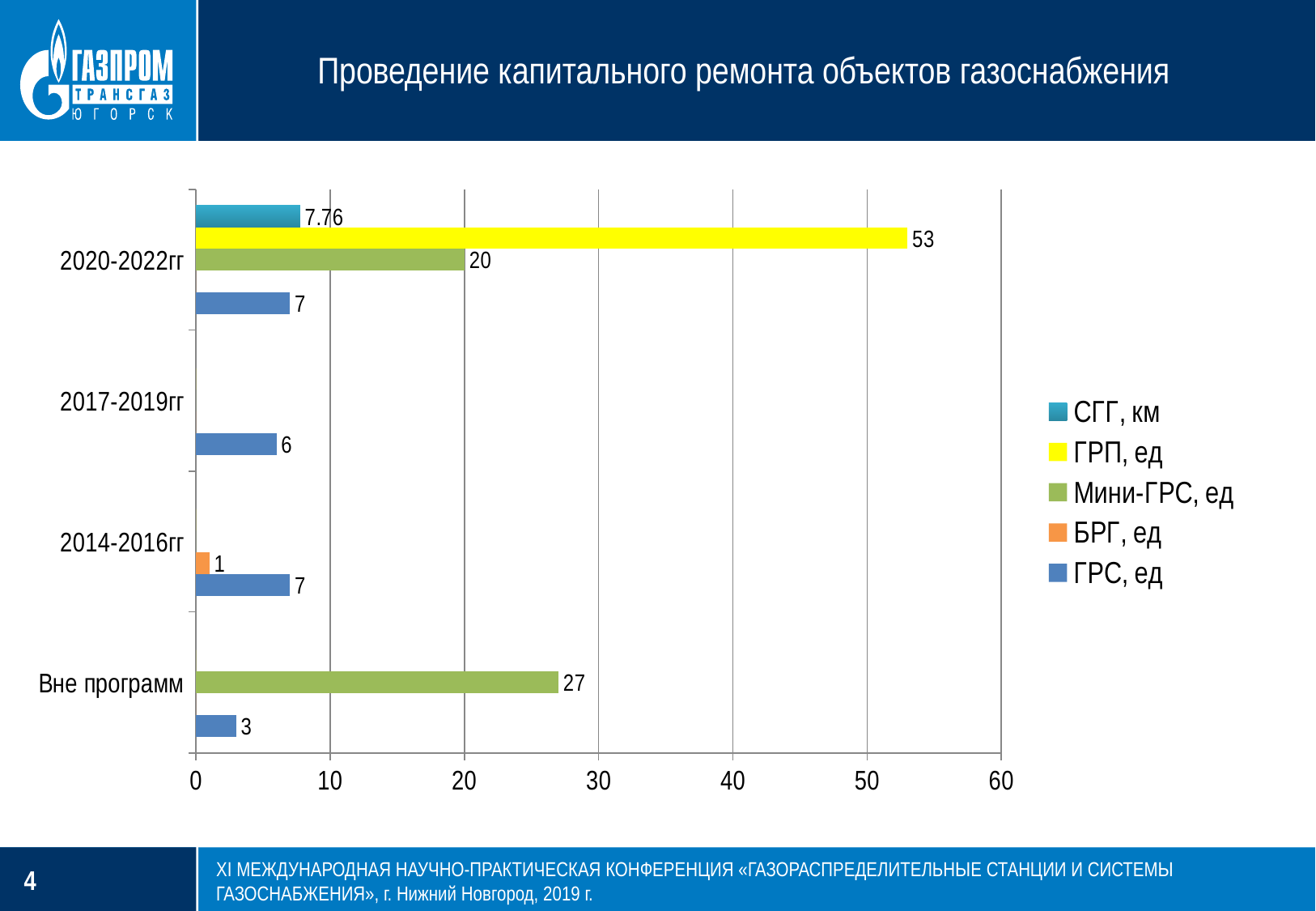
What is the value of ГРС, ед for 2017-2019гг? 6 What is the difference between Мини-ГРС, ед for Вне программ and for 2020-2022гг? 7 What is the value of БРГ, ед for 2014-2016гг? 1 What is the value of СГГ, км for 2020-2022гг? 7.76 Which is larger: ГРП, ед for 2020-2022гг or Мини-ГРС, ед for Вне программ? ГРП, ед for 2020-2022гг What is the value of Мини-ГРС, ед for Вне программ? 27 How many categories are shown on the vertical axis of the chart? 4 What type of chart is shown on the slide? bar chart How many series does the legend list? 5 What is the value of ГРП, ед for 2020-2022гг? 53 Which category has the lowest value for ГРС, ед? Вне программ Which category has the highest value for ГРС, ед? 2020-2022гг and 2014-2016гг (both 7)